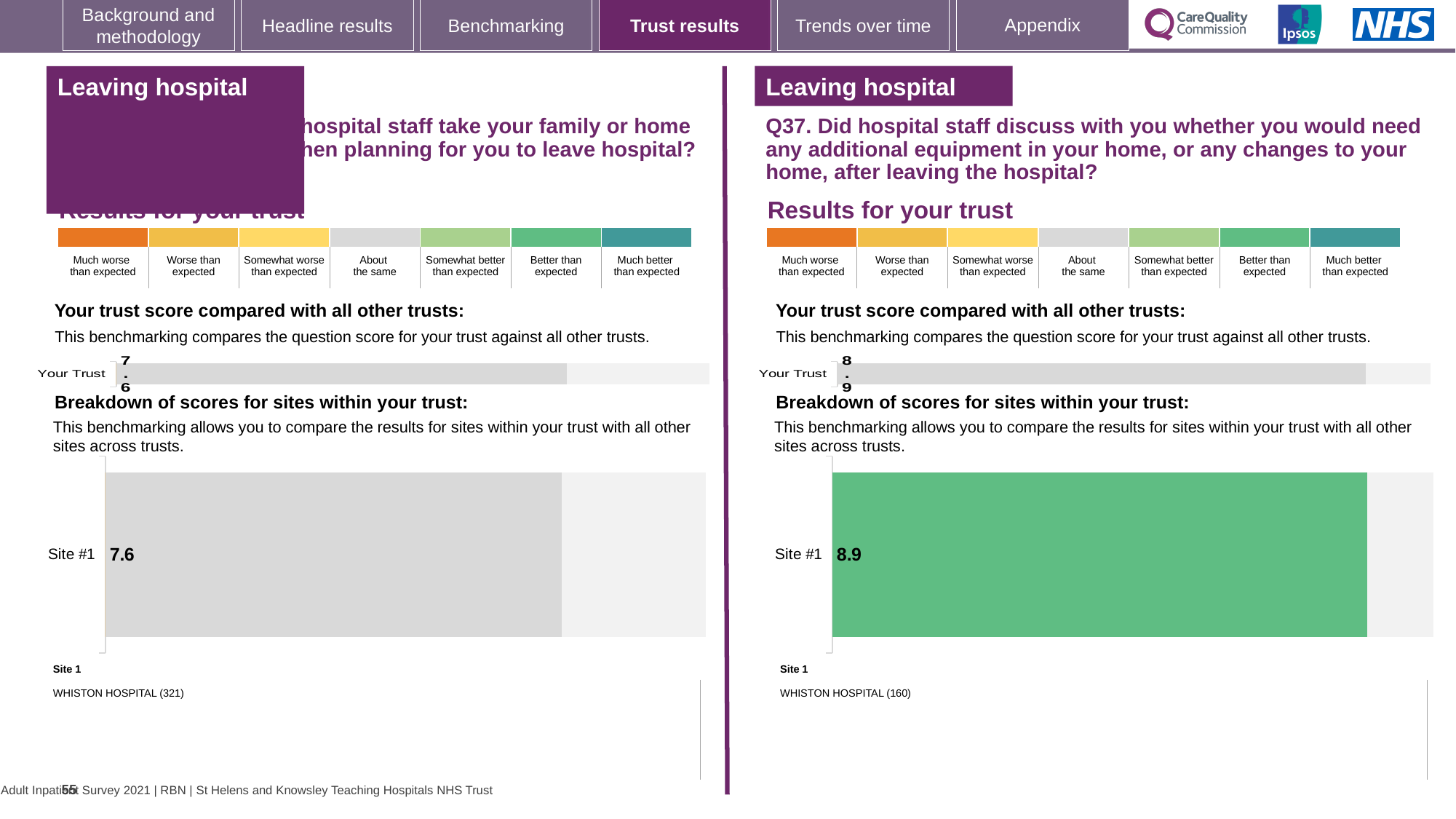
On the right-hand chart (Q37), which hospital is listed as Site 1? WHISTON HOSPITAL (160) On the right-hand chart (Q37), what is the score shown for Site #1? 8.9 What is the difference between the Site #1 score on the right-hand chart (Q37) and the Site #1 score on the left-hand chart? 1.3 On the right-hand chart (Q37), what colour is the Site #1 bar? Green On the left-hand chart, what is the score shown for Site #1? 7.6 Which is larger: the Site #1 score on the left-hand chart or the Site #1 score on the right-hand chart (Q37)? Right-hand chart (Q37) On the right-hand chart (Q37), what is the 'Your Trust' score? 8.9 On the right-hand chart (Q37), how many sites are shown in the breakdown of scores? 1 What type of chart is used for the breakdown of scores for sites on the right-hand side (Q37)? Bar chart On the left-hand chart, what is the 'Your Trust' score? 7.6